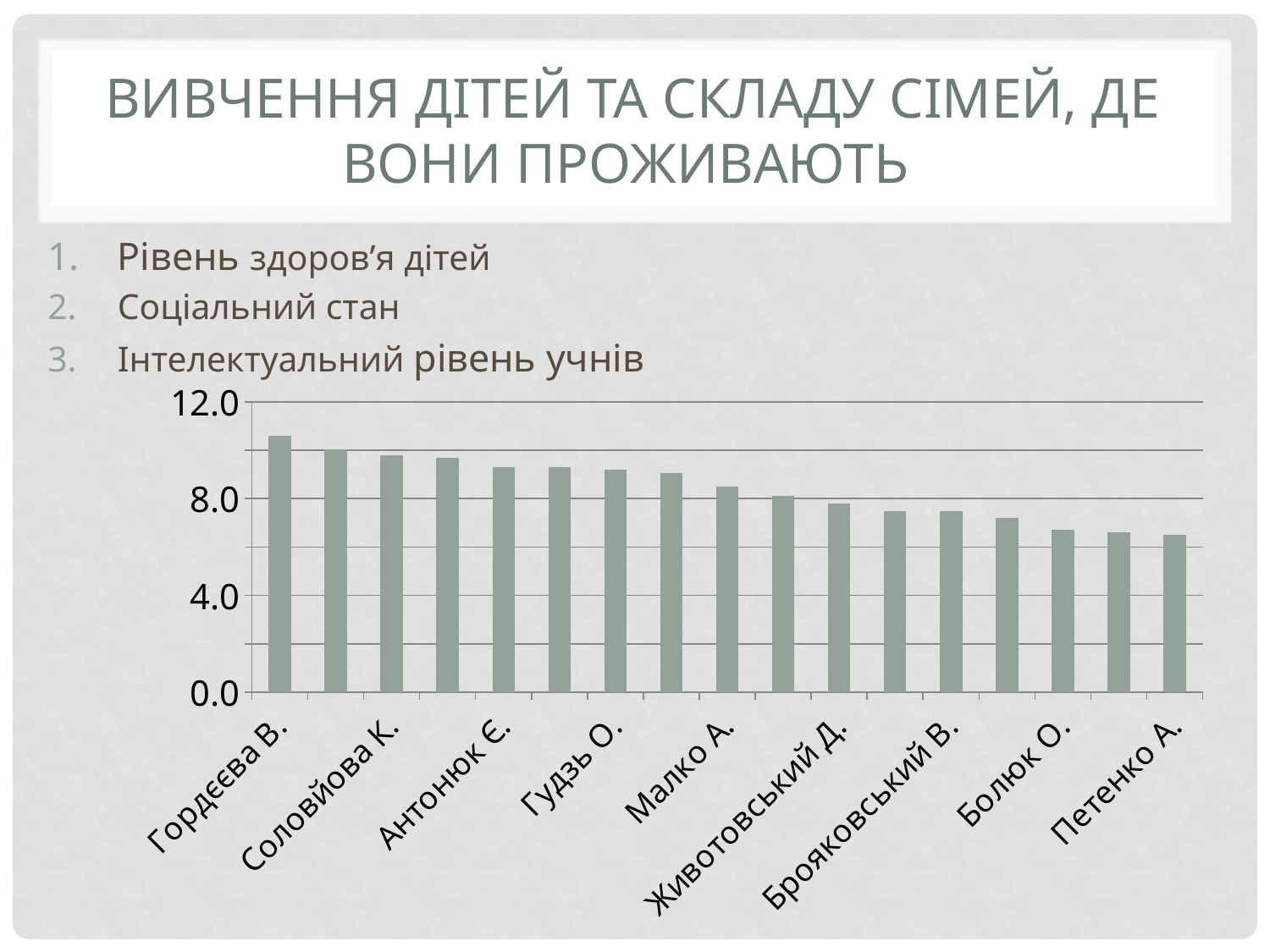
Is the value for Гордєєва В. greater or less than 8.0? greater Which category has the highest bar in the chart? Гордєєва В. How many bars are plotted in the chart? 17 Is the value for Соловйова К. greater or less than 8.0? greater What is the highest value shown on the vertical axis of the chart? 12.0 Is the value for Петенко А. greater or less than 8.0? less What kind of chart is shown on the slide? bar chart Which is larger, the value for Соловйова К. or the value for Болюк О.? Соловйова К. Which is larger, the value for Гордєєва В. or the value for Петенко А.? Гордєєва В. Do the bar values rise or fall from left to right across the chart? fall